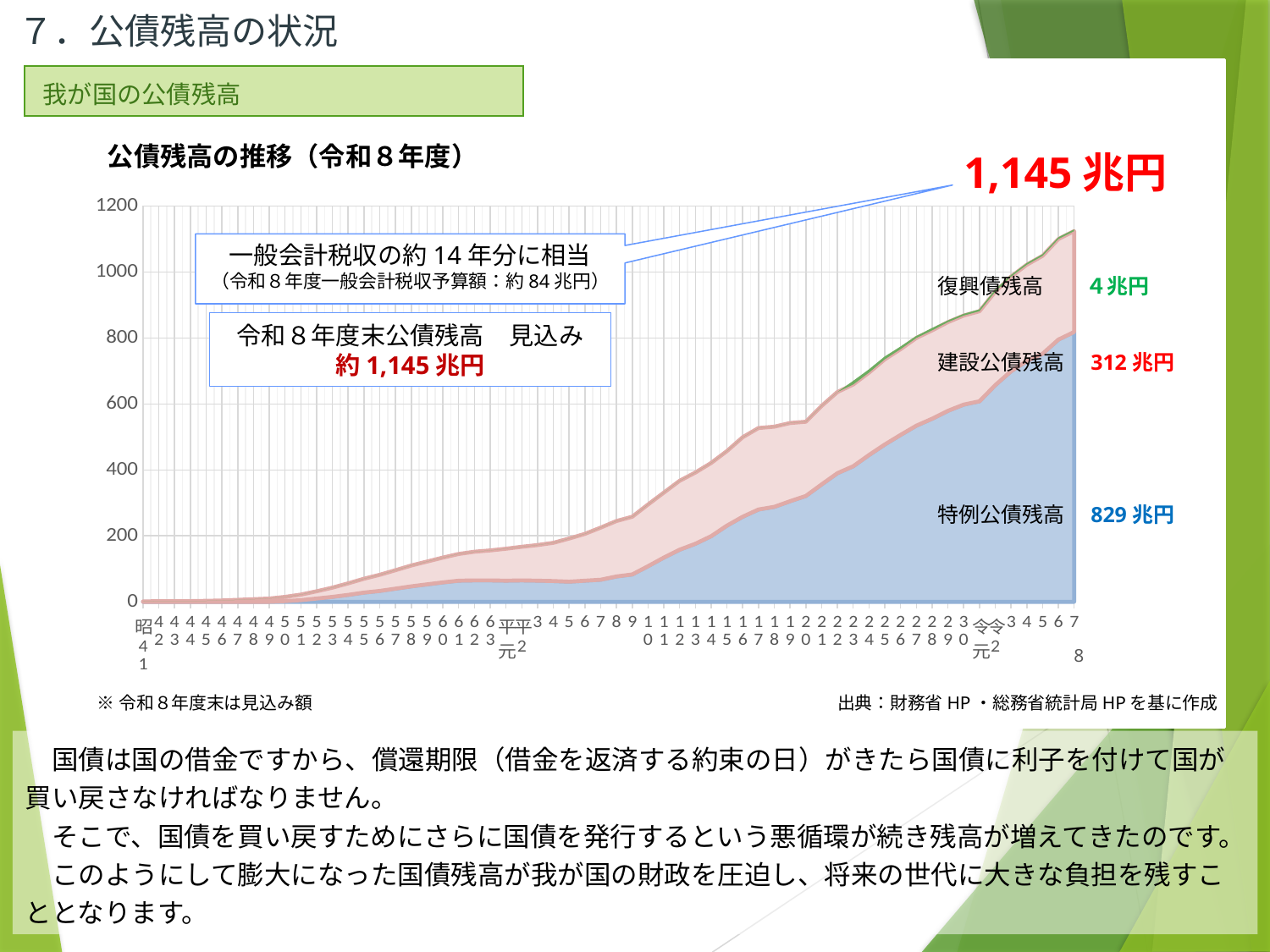
グラフ全体を通して、公債残高の合計は時間とともに増加していますか、減少していますか？ 増加 このグラフはどのような種類のグラフですか？ 積み上げ面グラフ グラフに示された令和8年度末の公債残高の合計はいくらですか？ 1,145兆円 グラフの令和8年度末における建設公債残高はいくらですか？ 312兆円 グラフの令和8年度末における復興債残高はいくらですか？ 4兆円 令和8年度末の残高で、最も小さい公債の種類はどれですか？ 復興債残高 グラフの令和8年度末における特例公債残高はいくらですか？ 829兆円 平成元年時点の公債残高の合計は200より大きいですか、小さいですか？ 小さい 令和8年度末の残高で、特例公債残高と建設公債残高ではどちらが大きいですか？ 特例公債残高 令和8年度末の残高で、最も大きい公債の種類はどれですか？ 特例公債残高 令和8年度末の残高で、特例公債残高と建設公債残高の差はいくらですか？ 517兆円 このグラフのタイトルは何ですか？ 公債残高の推移（令和8年度）